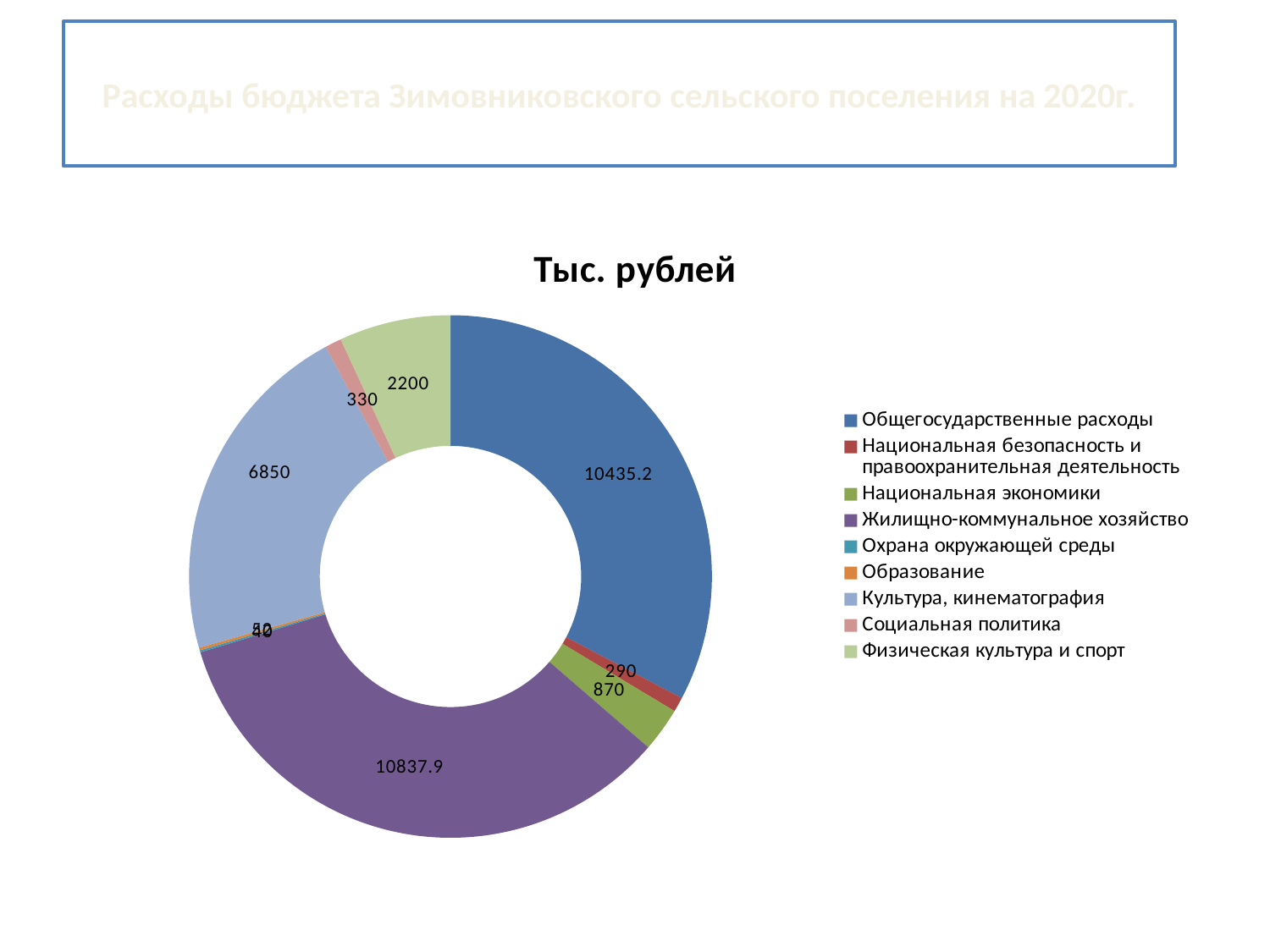
What is the value for Общегосударственные расходы? 10435.2 What is the value for Культура, кинематография? 6850 What is the value for Физическая культура и спорт? 2200 What is the value for Национальная безопасность и правоохранительная деятельность? 290 How many categories does the legend list? 9 What is the value for Национальная экономики? 870 What is the difference between Жилищно-коммунальное хозяйство and Общегосударственные расходы? 402.7 Which is larger, Культура, кинематография or Физическая культура и спорт? Культура, кинематография What is the value for Социальная политика? 330 What kind of chart is shown? doughnut chart Which category has the highest value? Жилищно-коммунальное хозяйство What is the value for Жилищно-коммунальное хозяйство? 10837.9